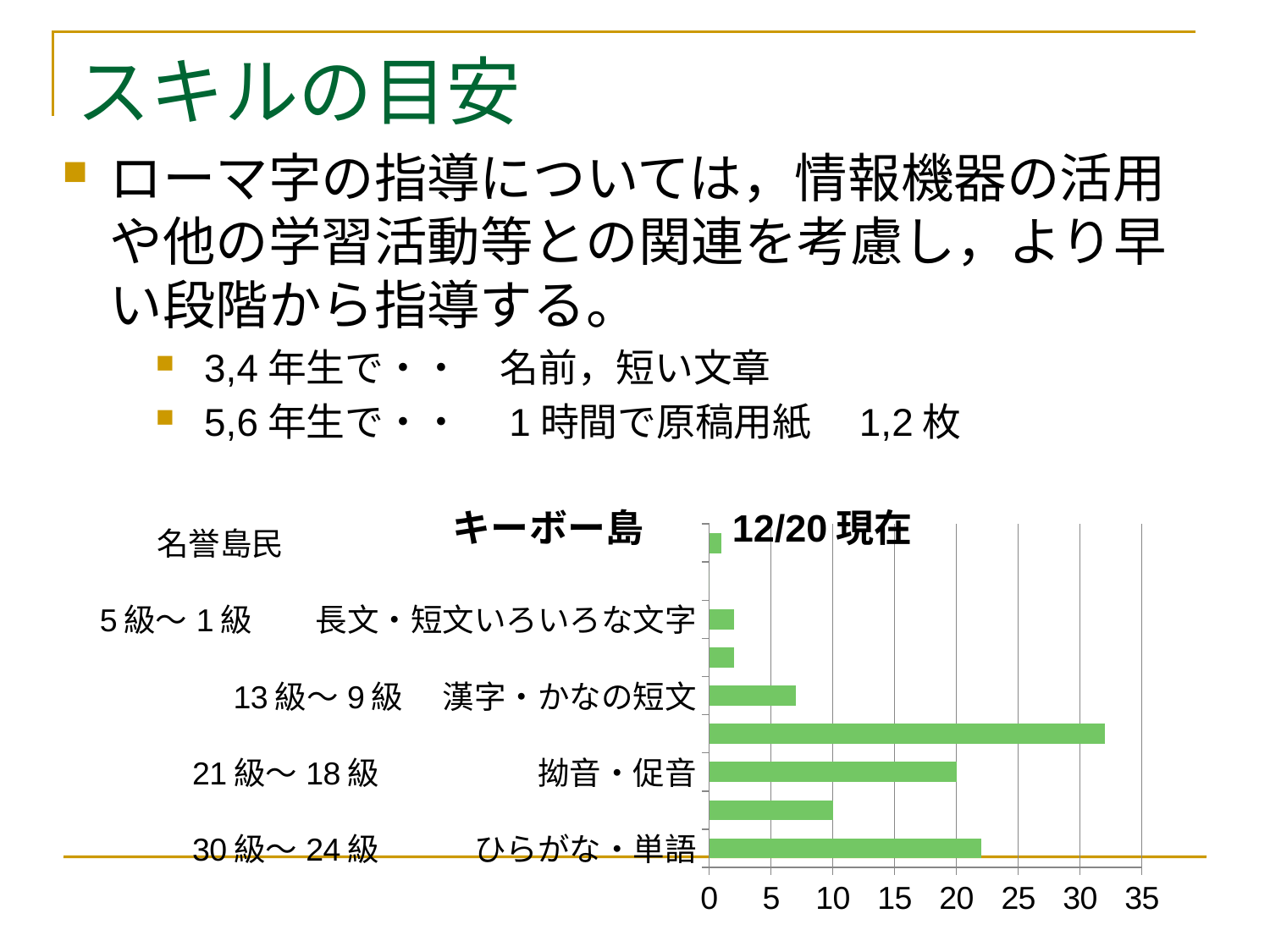
Is the value for 13級〜9級 漢字・かなの短文 greater or less than 5? greater Is the value for 13級〜9級 漢字・かなの短文 greater or less than 10? less What kind of chart is shown on the slide? bar chart What is the title of the chart? キーボー島 12/20 現在 How many bars are plotted in the chart? 8 What is the highest value shown on the horizontal axis of the chart? 35 Which is larger, the value for 名誉島民 or the value for 21級〜18級 拗音・促音? 21級〜18級 拗音・促音 Is the value for 21級〜18級 拗音・促音 greater or less than 15? greater Which is larger, the value for 30級〜24級 ひらがな・単語 or the value for 13級〜9級 漢字・かなの短文? 30級〜24級 ひらがな・単語